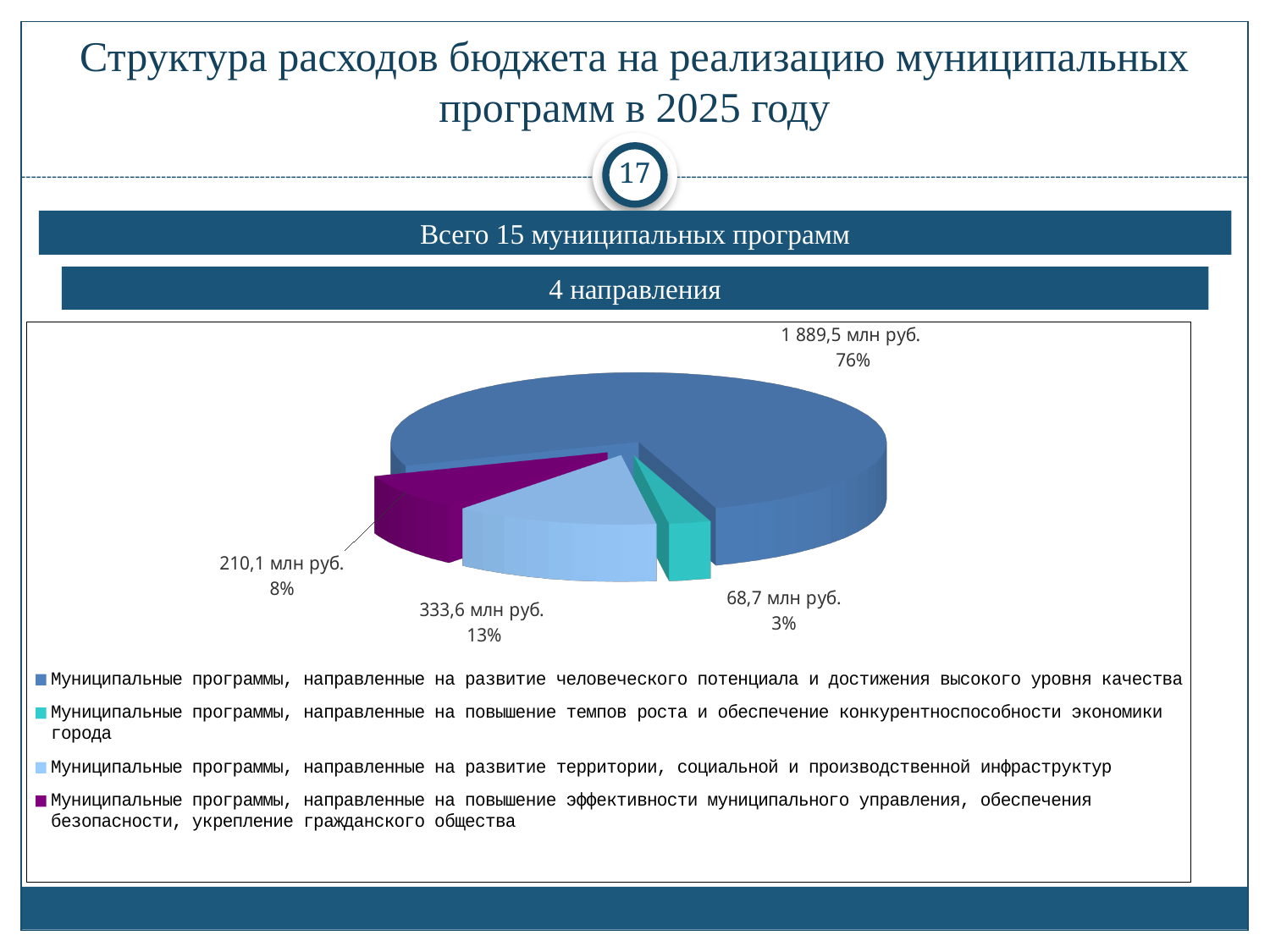
Which slice of the pie chart is the largest? Муниципальные программы, направленные на развитие человеческого потенциала и достижения высокого уровня качества What is the value shown for the slice 'Муниципальные программы, направленные на развитие человеческого потенциала и достижения высокого уровня качества'? 1 889,5 млн руб. What is the value shown for the slice 'Муниципальные программы, направленные на повышение эффективности муниципального управления, обеспечения безопасности, укрепление гражданского общества'? 210,1 млн руб. What kind of chart is shown on the slide? pie chart What is the value shown for the slice 'Муниципальные программы, направленные на повышение темпов роста и обеспечение конкурентноспособности экономики города'? 68,7 млн руб. What is the value shown for the slice 'Муниципальные программы, направленные на развитие территории, социальной и производственной инфраструктур'? 333,6 млн руб. How many slices does the pie chart have? 4 Which is larger: the slice for programs on territory and infrastructure development (333,6 млн руб.) or the slice for programs on municipal management efficiency (210,1 млн руб.)? Муниципальные программы, направленные на развитие территории, социальной и производственной инфраструктур What share of the pie does the slice for programs aimed at developing human potential ('развитие человеческого потенциала') represent? 76% What share of the pie does the slice for programs aimed at developing territory, social and production infrastructure ('развитие территории, социальной и производственной инфраструктур') represent? 13% How many entries does the legend of the pie chart list? 4 Which slice of the pie chart is the smallest? Муниципальные программы, направленные на повышение темпов роста и обеспечение конкурентноспособности экономики города